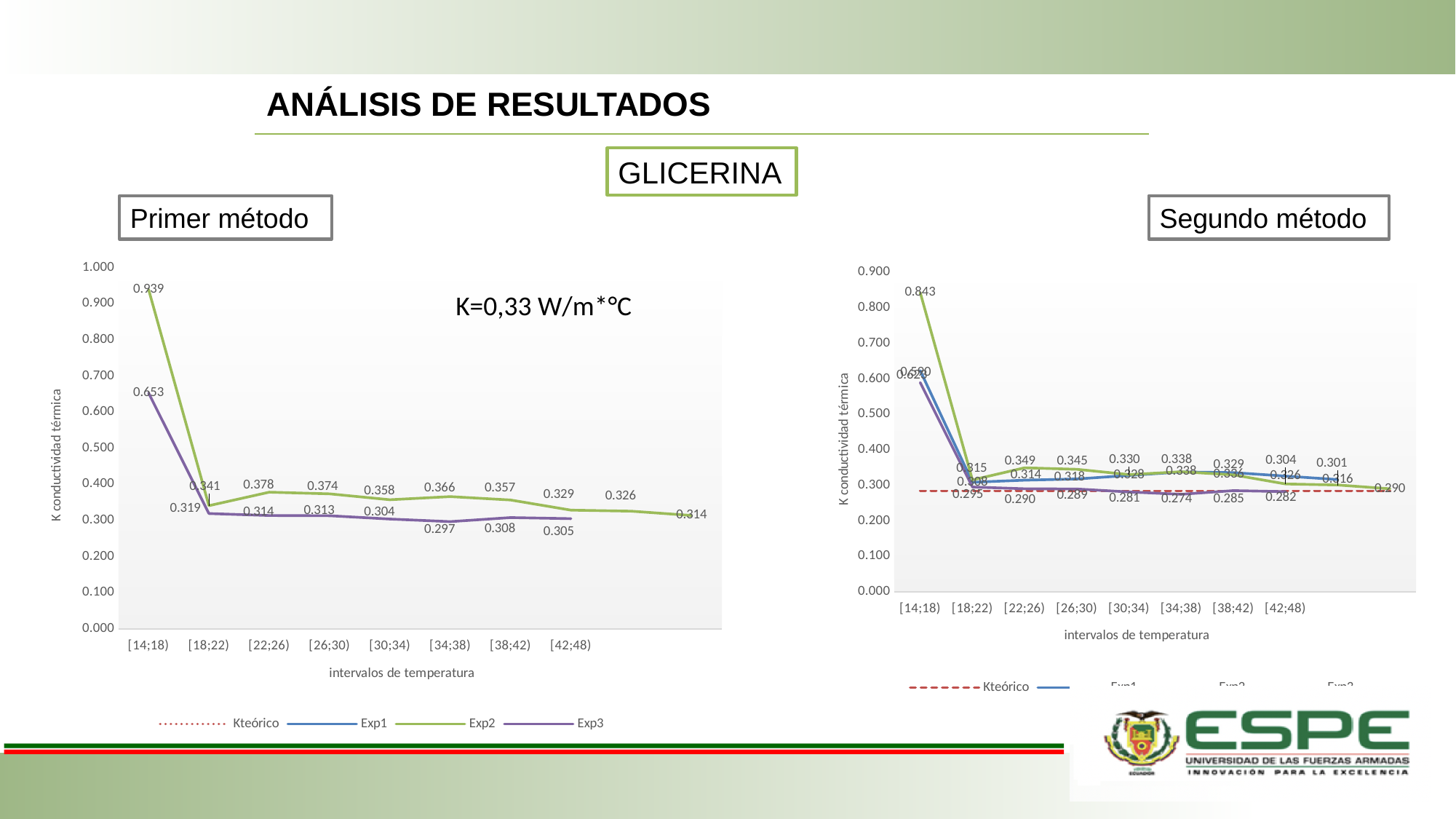
In the 'Segundo método' chart, what is the Exp3 value at the [34;38] interval? 0.274 In the 'Primer método' chart, which series has the higher value at the [14;18] interval, Exp2 or Exp3? Exp2 In the 'Primer método' chart, what is the difference between the Exp2 and Exp3 values at the [14;18] interval? 0.286 In the 'Primer método' chart, what is the Exp3 value at the [14;18] interval? 0.653 What kind of chart is the 'Primer método' chart? line chart In the 'Segundo método' chart, at which interval does Exp2 reach its highest value? [14;18] In the 'Primer método' chart, what is the Exp2 value at the [14;18] interval? 0.939 In the 'Primer método' chart, what is the Exp3 value at the [18;22] interval? 0.319 What theoretical K value is written on the 'Primer método' chart? K=0,33 W/m*°C In the 'Segundo método' chart, what is the Exp2 value at the [14;18] interval? 0.843 How many series does the legend of the 'Primer método' chart list? 4 In the 'Segundo método' chart, does the Exp2 line rise or fall from the [14;18] interval to the [18;22] interval? fall